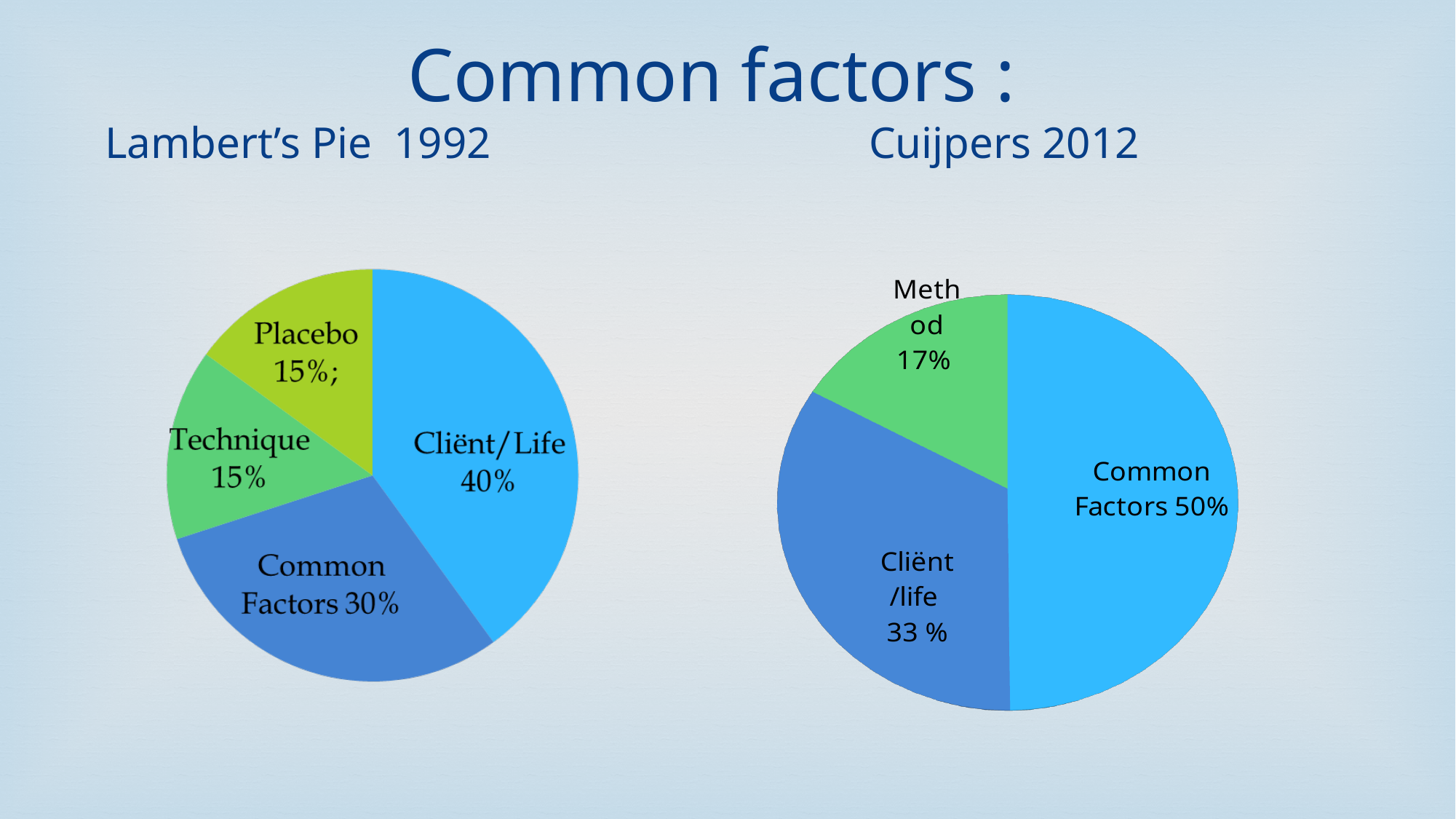
In the Cuijpers 2012 chart, which category has the smallest slice? Method In the Lambert's Pie 1992 chart, what is the difference between Cliënt/Life and Common Factors? 10% In the Cuijpers 2012 chart, what is the value for Cliënt/life? 33 % In the Lambert's Pie 1992 chart, how many slices does the pie have? 4 What kind of chart is the Cuijpers 2012 chart? Pie chart In the Lambert's Pie 1992 chart, what is the value for Cliënt/Life? 40% In the Lambert's Pie 1992 chart, which category has the largest slice? Cliënt/Life In the Lambert's Pie 1992 chart, what is the value for Common Factors? 30% In the Cuijpers 2012 chart, what is the value for Method? 17% What is the title of the slide? Common factors : In the Cuijpers 2012 chart, which is larger, Common Factors or Cliënt/life? Common Factors In the Cuijpers 2012 chart, how many slices does the pie have? 3